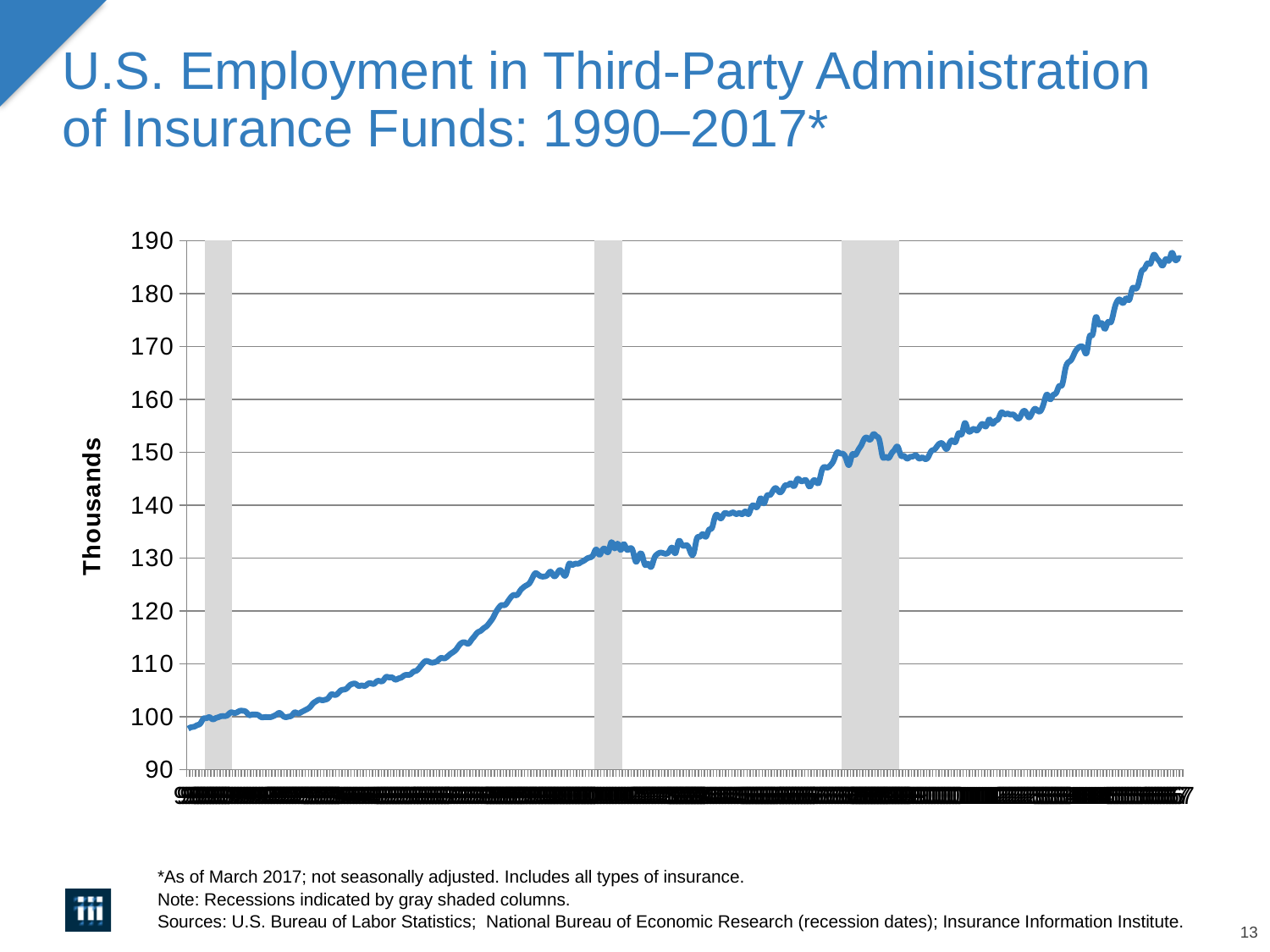
What kind of chart is shown on the slide? line chart Is the peak reached just before the second gray recession column greater or less than 140? less Is the value at the end of the series greater or less than 180? greater Is the highest value reached by the line greater or less than 190? less How many gray shaded recession columns appear on the chart? 3 Overall, do the values rise or fall from the start to the end of the series? rise How many data series are plotted on the chart? 1 Which is larger, the value at the start of the series or the value at the end of the series? the end of the series What is the label on the vertical axis of the chart? Thousands